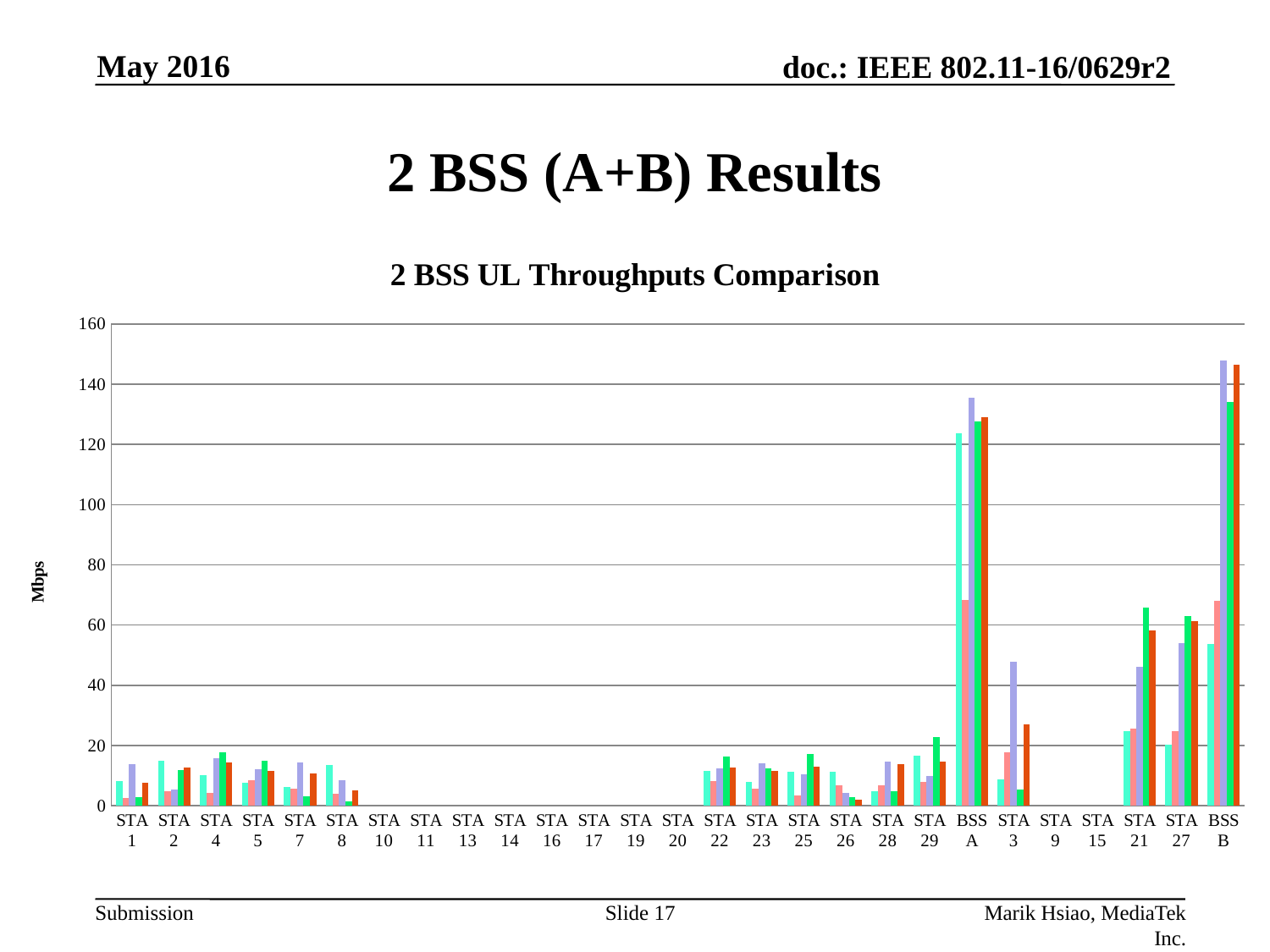
What kind of chart is shown on the slide? bar chart Is the tallest bar for STA 21 greater or less than 60? greater Is the tallest bar for STA 3 greater or less than 40? greater Which has the taller tallest bar, BSS A or BSS B? BSS B Which has the taller tallest bar, STA 3 or STA 27? STA 27 Is the tallest bar for BSS A greater or less than 120? greater Which category has the tallest bar in the chart? BSS B What is the title of the chart? 2 BSS UL Throughputs Comparison What is the label on the vertical axis of the chart? Mbps How many categories are shown along the x axis of the chart? 27